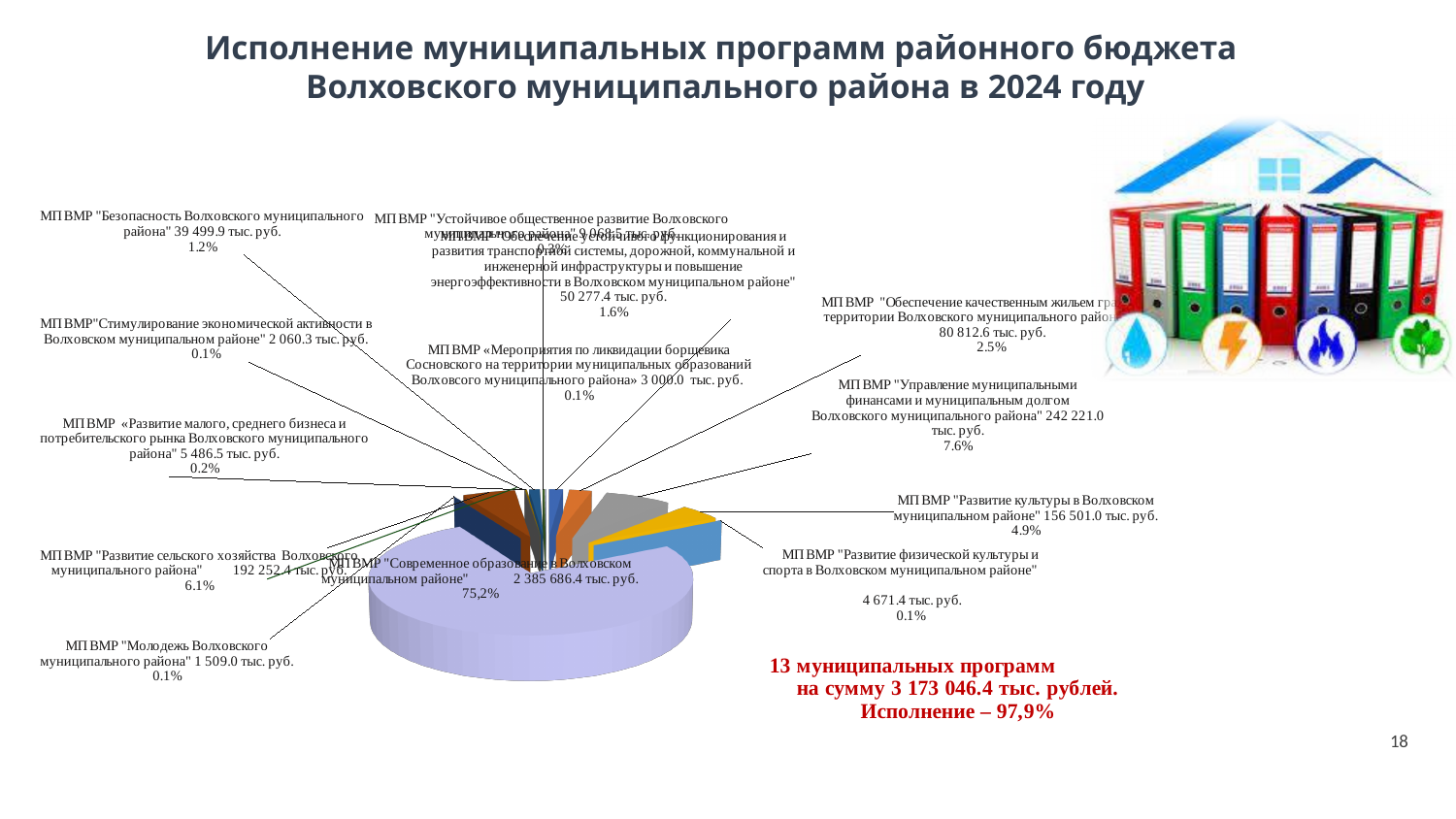
What total amount of the municipal programmes is stated on the slide? 3 173 046.4 тыс. рублей What share of the pie does the programme "Развитие сельского хозяйства Волховского муниципального района" have? 6.1% Which municipal programme has the largest share of the pie? МП ВМР "Современное образование в Волховском муниципальном районе" Which is larger: the amount for "Управление муниципальными финансами и муниципальным долгом" or for "Развитие сельского хозяйства"? Управление муниципальными финансами и муниципальным долгом How many municipal programmes does the slide say are included? 13 What is the amount shown for the programme "Развитие культуры в Волховском муниципальном районе"? 156 501.0 тыс. руб. What share of the pie does the programme "Современное образование в Волховском муниципальном районе" have? 75,2% What is the amount shown for the programme "Управление муниципальными финансами и муниципальным долгом Волховского муниципального района"? 242 221.0 тыс. руб. Which programme has the smallest amount shown on the chart? МП ВМР "Молодежь Волховского муниципального района" (1 509.0 тыс. руб.) What is the difference between the amounts for "Развитие культуры" (156 501.0 тыс. руб.) and "Обеспечение качественным жильем граждан" (80 812.6 тыс. руб.)? 75 688.4 тыс. руб. What is the amount shown for the programme "Безопасность Волховского муниципального района"? 39 499.9 тыс. руб. What kind of chart is shown on the slide? Pie chart